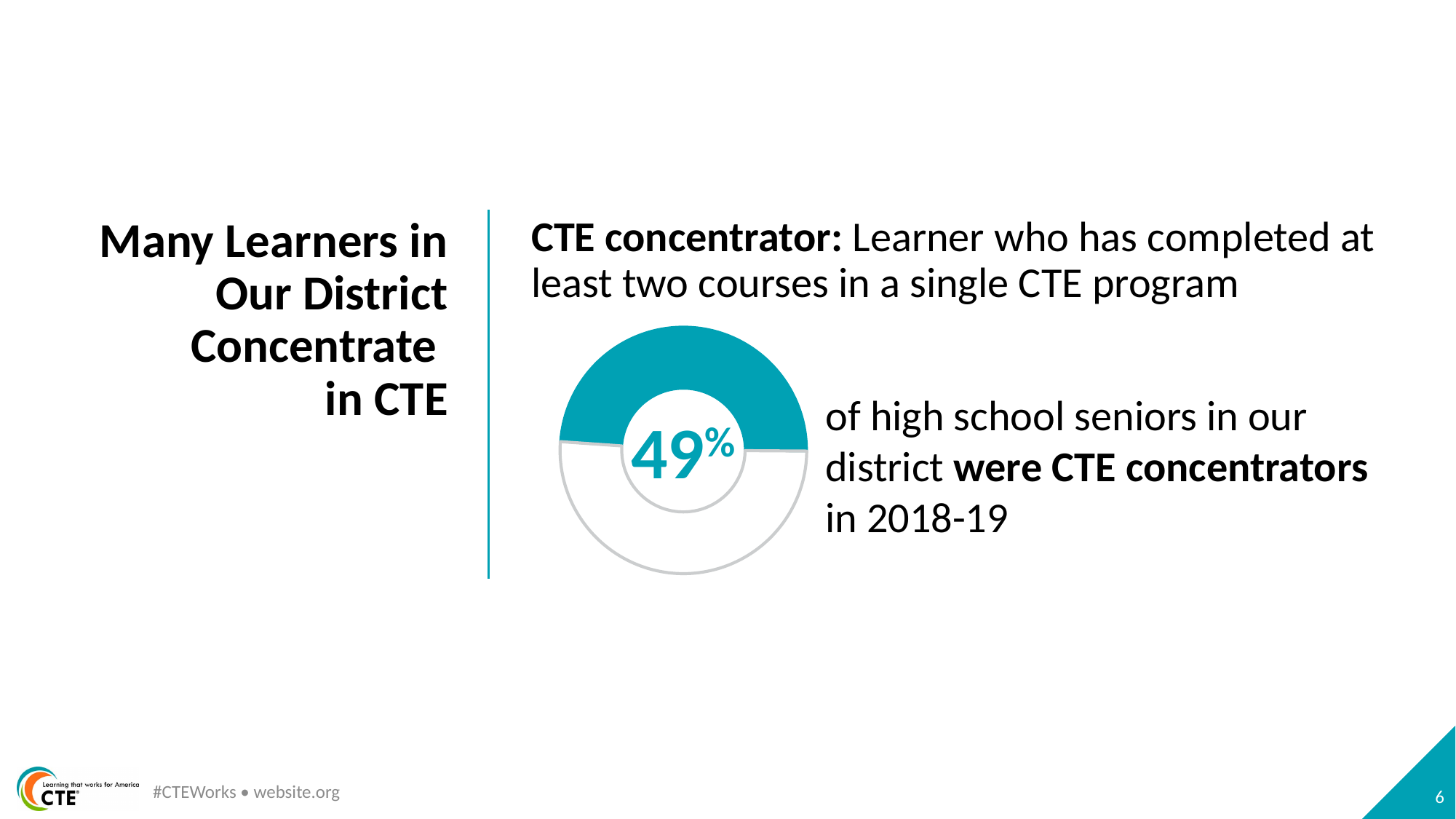
How many segments does the donut chart have? 2 What school year does the 49% figure in the chart refer to? 2018-19 What percentage of high school seniors in the district were CTE concentrators in 2018-19, according to the chart? 49% What colour is the segment representing CTE concentrators in the donut chart? Teal Is the share of seniors who were CTE concentrators greater or less than 50%? less What kind of chart is used to show the share of CTE concentrators? Donut (pie) chart What share of the donut chart is filled in teal? 49%